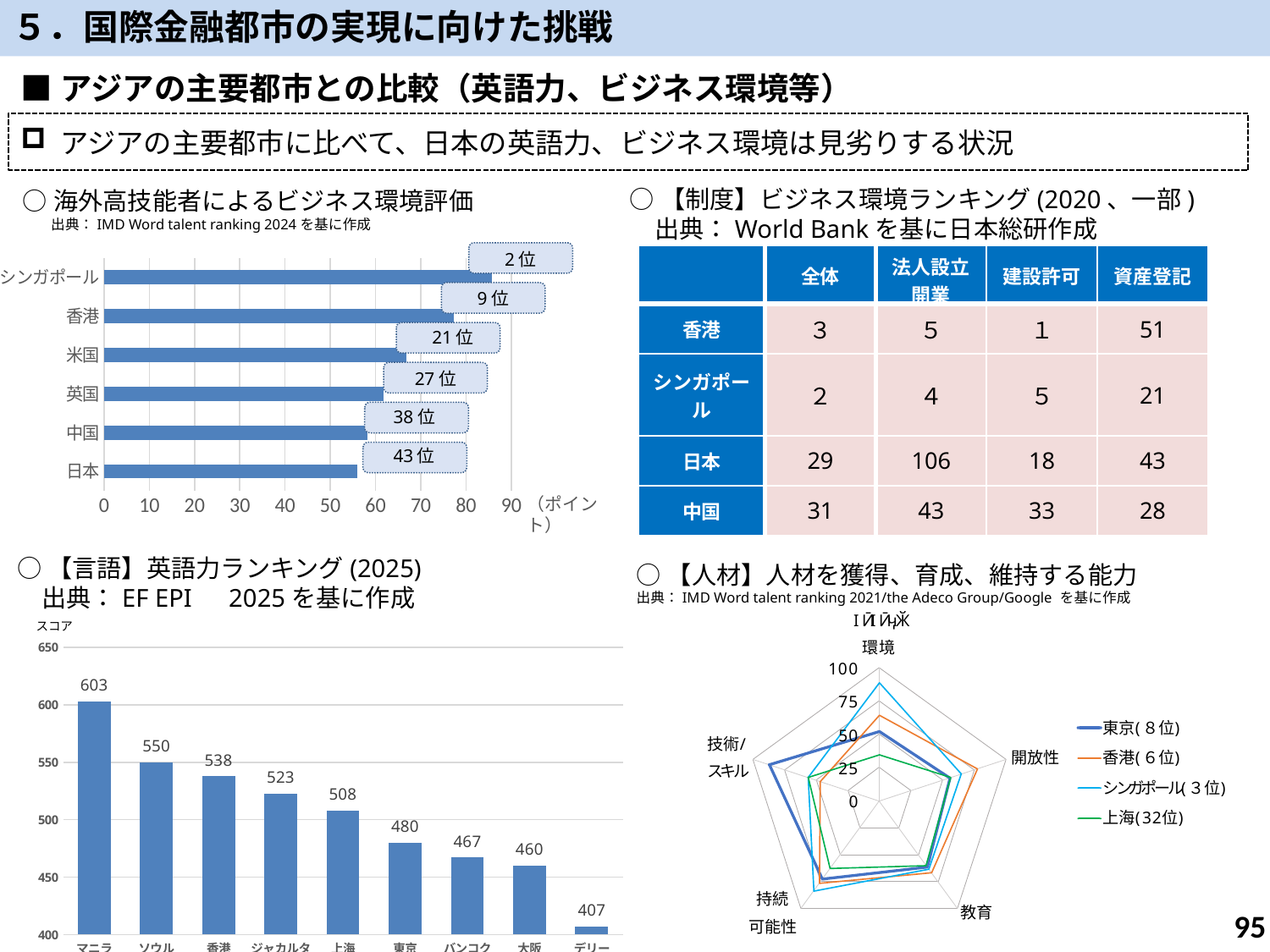
In the top-left bar chart (海外高技能者によるビジネス環境評価), what rank label is shown for シンガポール? 2位 In the bottom-left bar chart (英語力ランキング 2025), what is the score for マニラ? 603 What kind of chart is the bottom-right chart (人材を獲得、育成、維持する能力)? radar chart In the top-left bar chart (海外高技能者によるビジネス環境評価), is the value for 日本 greater or less than 60? less In the bottom-left bar chart (英語力ランキング 2025), which city has the lowest score? デリー In the bottom-right radar chart (人材を獲得、育成、維持する能力), how many series does the legend list? 4 In the top-left bar chart (海外高技能者によるビジネス環境評価), how many countries/regions are plotted? 6 In the bottom-left bar chart (英語力ランキング 2025), do the scores rise or fall from left to right? fall In the top-left bar chart (海外高技能者によるビジネス環境評価), is the value for シンガポール greater or less than 80? greater In the top-left bar chart (海外高技能者によるビジネス環境評価), what rank label is shown for 日本? 43位 In the bottom-left bar chart (英語力ランキング 2025), what is the difference between the scores of ソウル and 大阪? 90 In the bottom-left bar chart (英語力ランキング 2025), what is the score for 東京? 480